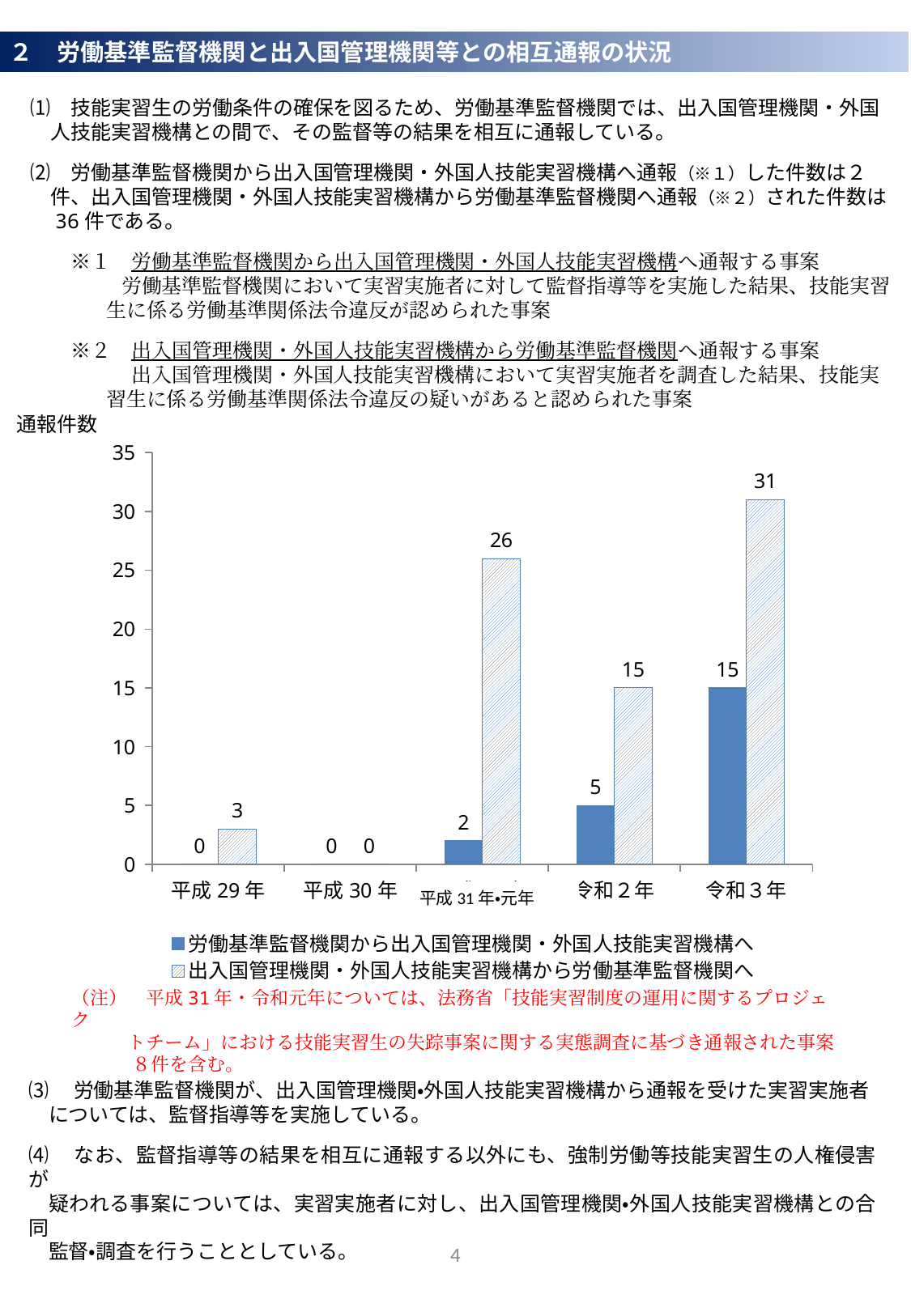
令和3年の2つの系列の通報件数の差はいくつですか？ 16 このグラフはどの種類のグラフですか？ 棒グラフ 「労働基準監督機関から出入国管理機関・外国人技能実習機構へ」の通報件数が最も多い年はどれですか？ 令和3年 グラフの縦軸のラベルは何ですか？ 通報件数 令和2年の「労働基準監督機関から出入国管理機関・外国人技能実習機構へ」の通報件数はいくつですか？ 5 令和2年では、どちらの系列の通報件数が多いですか？ 出入国管理機関・外国人技能実習機構から労働基準監督機関へ 令和3年の「出入国管理機関・外国人技能実習機構から労働基準監督機関へ」の通報件数はいくつですか？ 31 凡例にはいくつの系列が示されていますか？ 2 「出入国管理機関・外国人技能実習機構から労働基準監督機関へ」の通報件数が最も多い年はどれですか？ 令和3年 平成31年・元年の「出入国管理機関・外国人技能実習機構から労働基準監督機関へ」の通報件数はいくつですか？ 26 グラフの横軸には何年分のカテゴリがありますか？ 5 「労働基準監督機関から出入国管理機関・外国人技能実習機構へ」の通報件数は平成31年・元年から令和3年にかけて増加していますか、減少していますか？ 増加